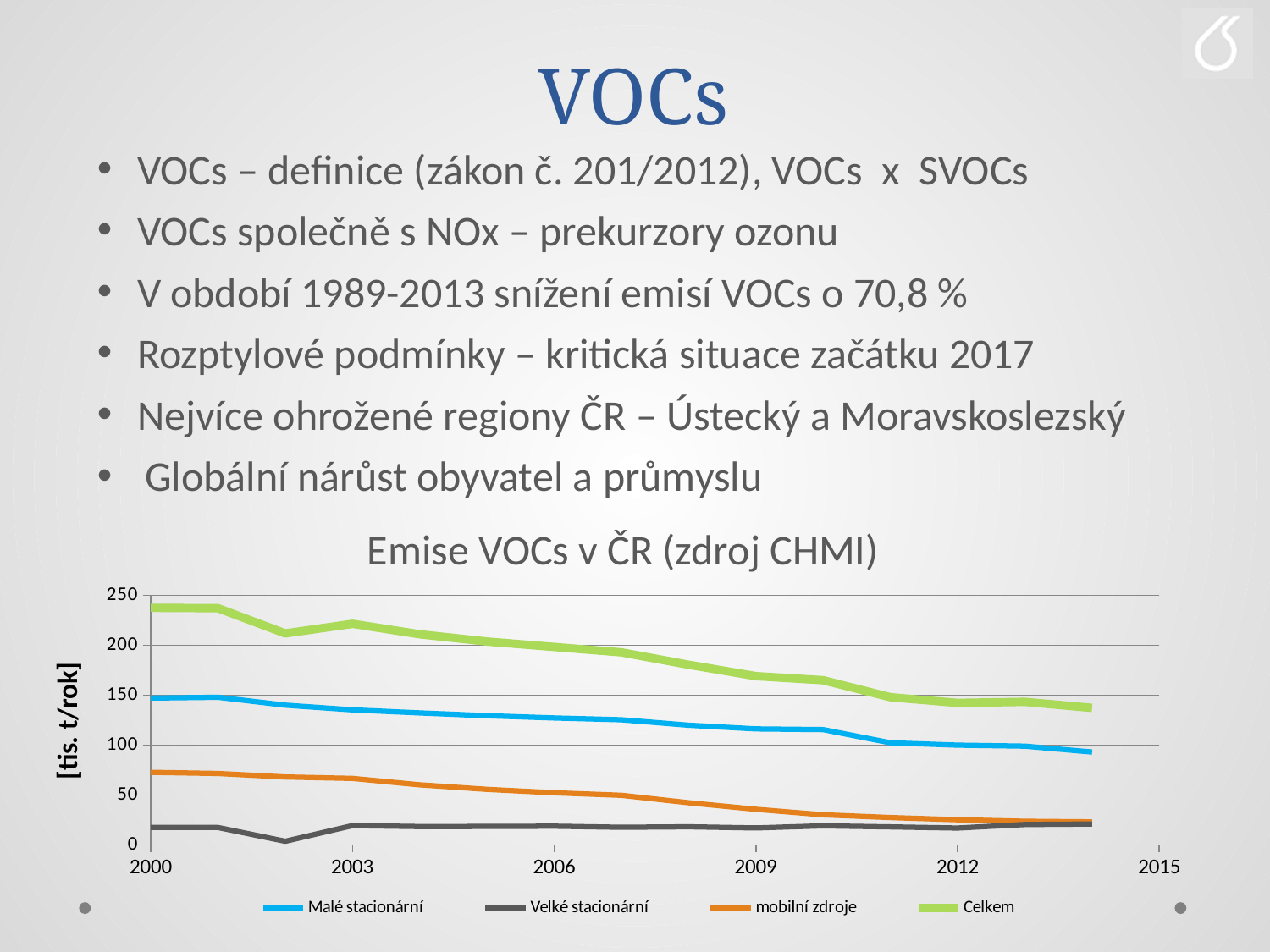
Is the value for Celkem in 2000 greater or less than 200? greater Which series has the highest value in 2000? Celkem Is the value for Celkem in 2014 greater or less than 150? less Which series has the lowest value in 2000? Velké stacionární Is the value for Velké stacionární in 2003 greater or less than 50? less How many series does the legend of the chart list? 4 What kind of chart is shown on the slide? line chart Does the Celkem series rise or fall from 2000 to 2014? fall What is the label of the vertical axis of the chart? [tis. t/rok] What is the title of the chart? Emise VOCs v ČR (zdroj CHMI)